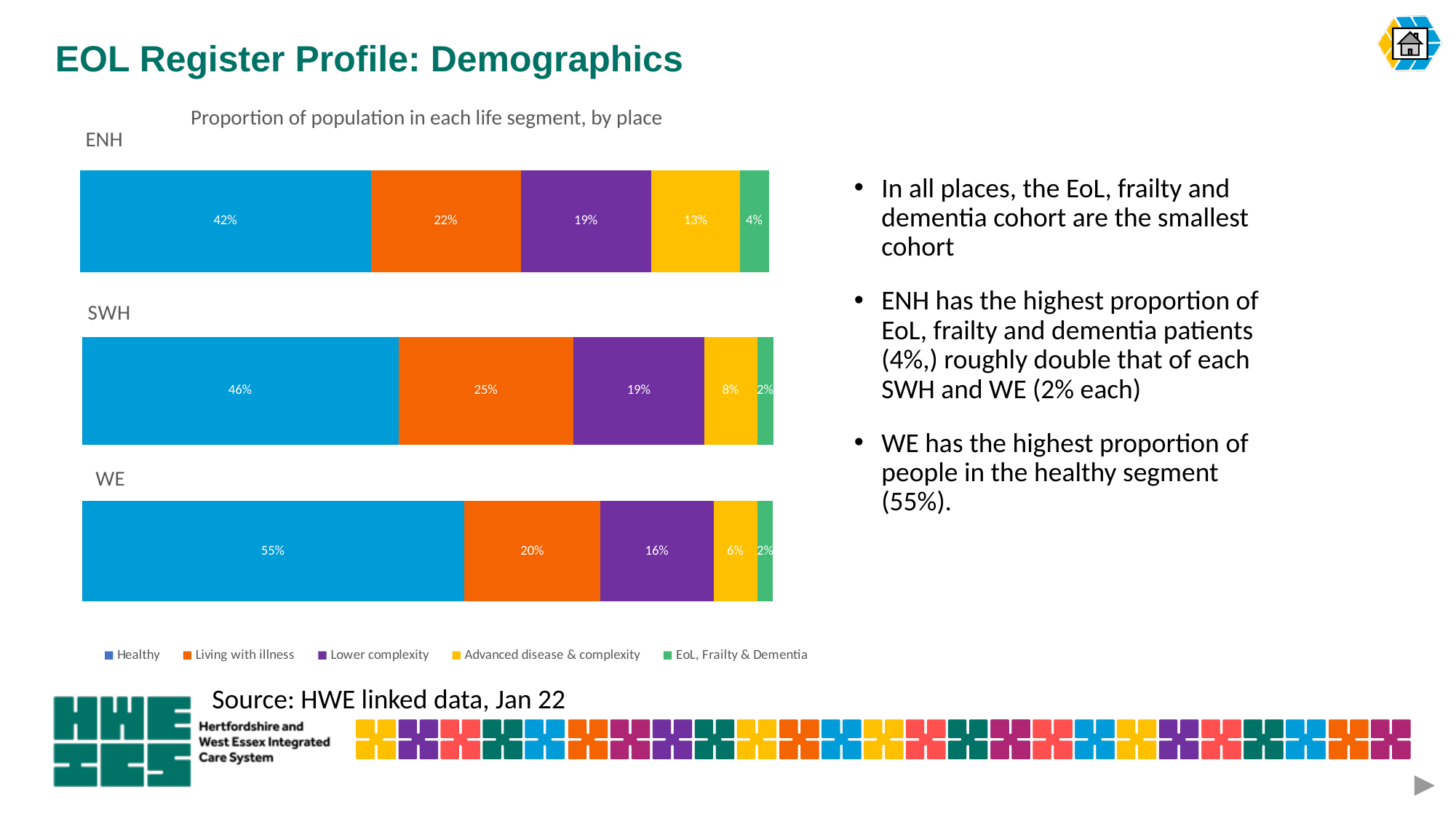
What is the Healthy proportion for ENH? 42% What is the title of the chart? Proportion of population in each life segment, by place Which place has the lowest Advanced disease & complexity proportion? WE What is the Living with illness proportion for SWH? 25% What is the Advanced disease & complexity proportion for WE? 6% How many series does the legend list? 5 What kind of chart is shown on the slide? Stacked bar chart Which is larger, the Lower complexity proportion for SWH or for WE? SWH Which place has the highest Healthy proportion? WE What is the EoL, Frailty & Dementia proportion for ENH? 4% How many places are shown in the chart? 3 What is the difference between the Healthy proportion for WE and for ENH? 13%